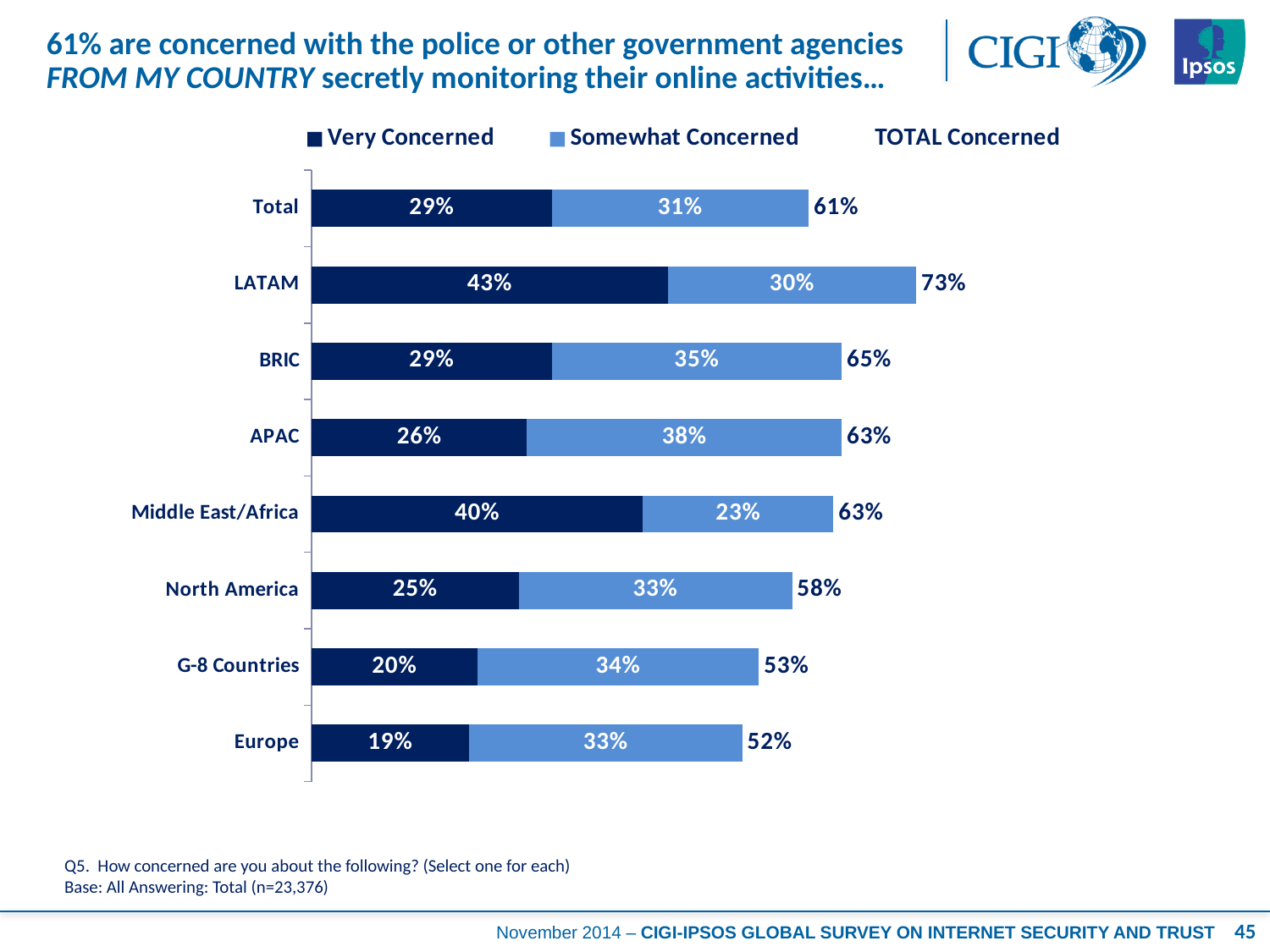
What is the Somewhat Concerned value for APAC? 38% What type of chart is shown on the slide? Stacked bar chart Which region has the lowest Very Concerned value? Europe How many entries does the legend list? 3 Which has a larger Somewhat Concerned value, BRIC or Middle East/Africa? BRIC What is the TOTAL Concerned value for North America? 58% What is the TOTAL Concerned value shown for the G-8 Countries bar? 53% What is the difference between the Very Concerned values for LATAM and Europe? 24% Which colour represents the Very Concerned series? Dark navy blue What percentage of LATAM respondents are Very Concerned? 43% How many regional categories (including Total) are shown on the chart? 8 Which region has the highest TOTAL Concerned value? LATAM